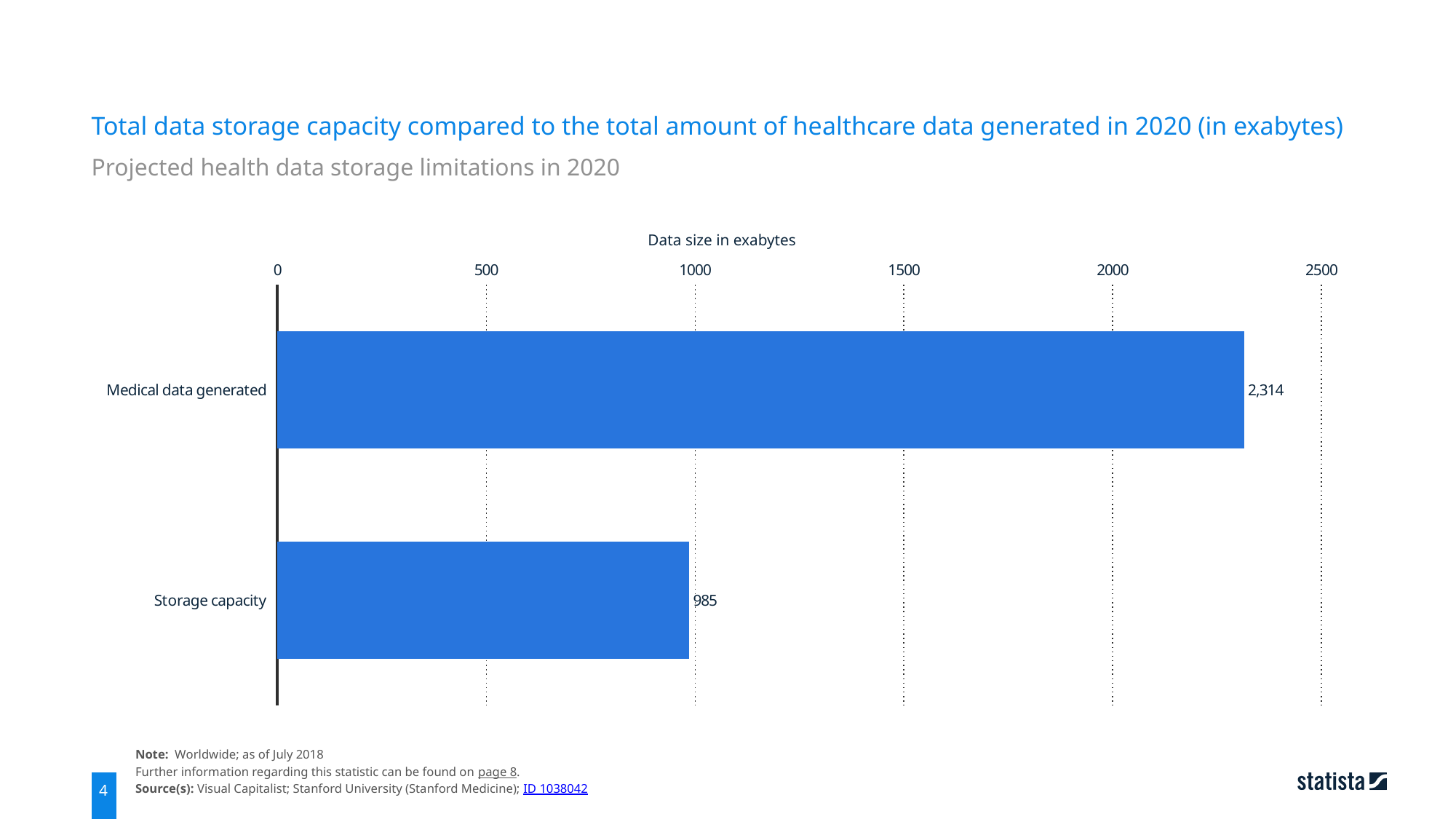
Which category has the highest value? Medical data generated What is the value for Medical data generated? 2,314 What kind of chart is shown on the slide? Bar chart What is the subtitle of the chart? Projected health data storage limitations in 2020 Is the value for Storage capacity greater or less than 1000? less How many categories are shown in the chart? 2 What is the difference between Medical data generated and Storage capacity? 1,329 Which is larger, Medical data generated or Storage capacity? Medical data generated What is the value for Storage capacity? 985 Which category has the lowest value? Storage capacity What is the label of the value axis? Data size in exabytes Is the value for Medical data generated greater or less than 2000? greater